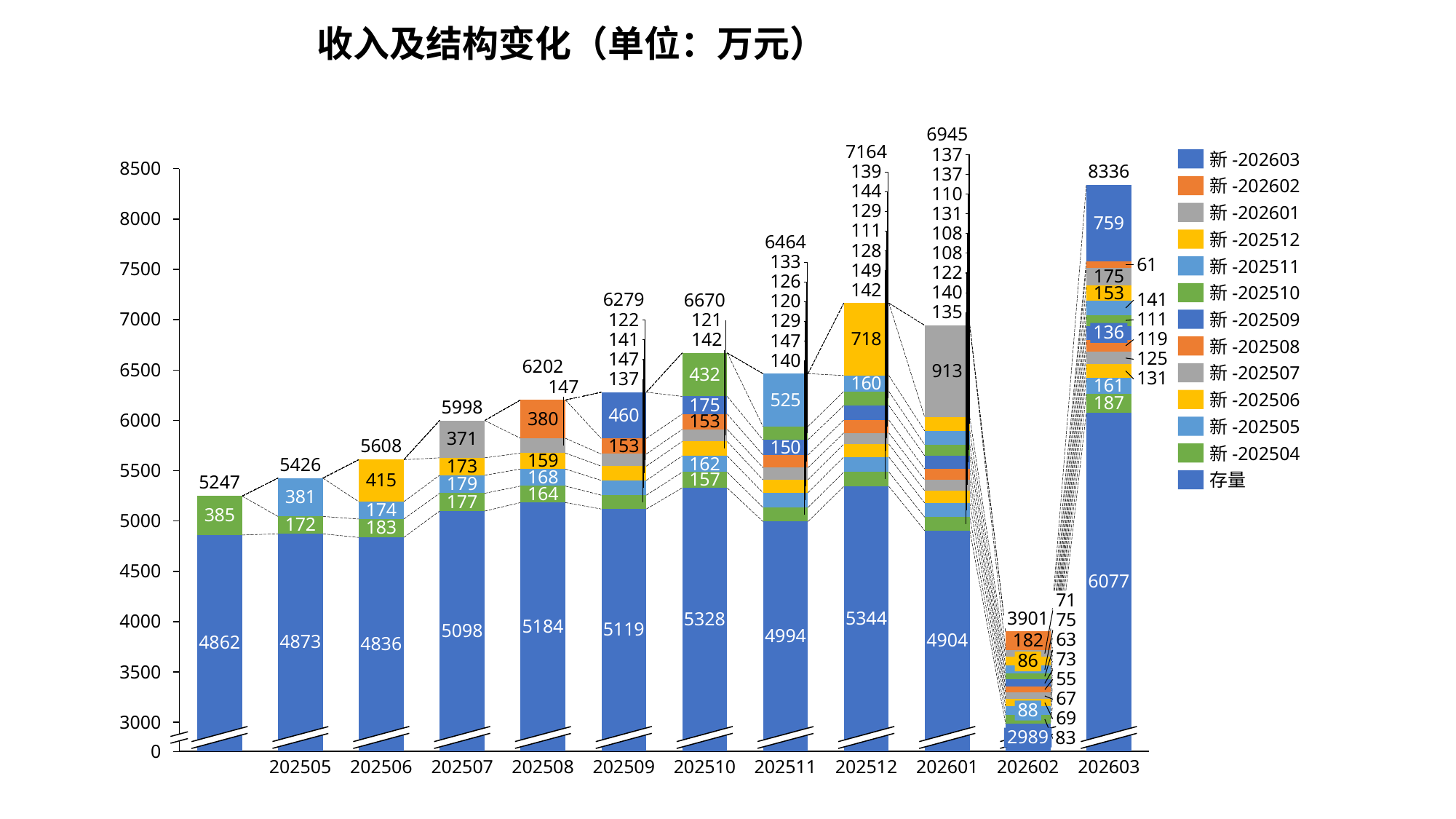
What is the 存量 value for 202602? 2989 How many series does the legend list? 13 What is the value of the 新-202601 segment in the 202601 bar? 913 What is the value of the 新-202512 segment in the 202512 bar? 718 Which has a larger total, 202512 or 202601? 202512 What kind of chart is shown on the slide? stacked bar chart Which month has the lowest total value? 202602 What is the difference between the 存量 value for 202603 and the 存量 value for 202602? 3088 What is the title of the chart? 收入及结构变化（单位：万元） What is the total value of the bar for 202603? 8336 Which month has the highest total value? 202603 What is the difference between the total for 202603 and the total for 202602? 4435